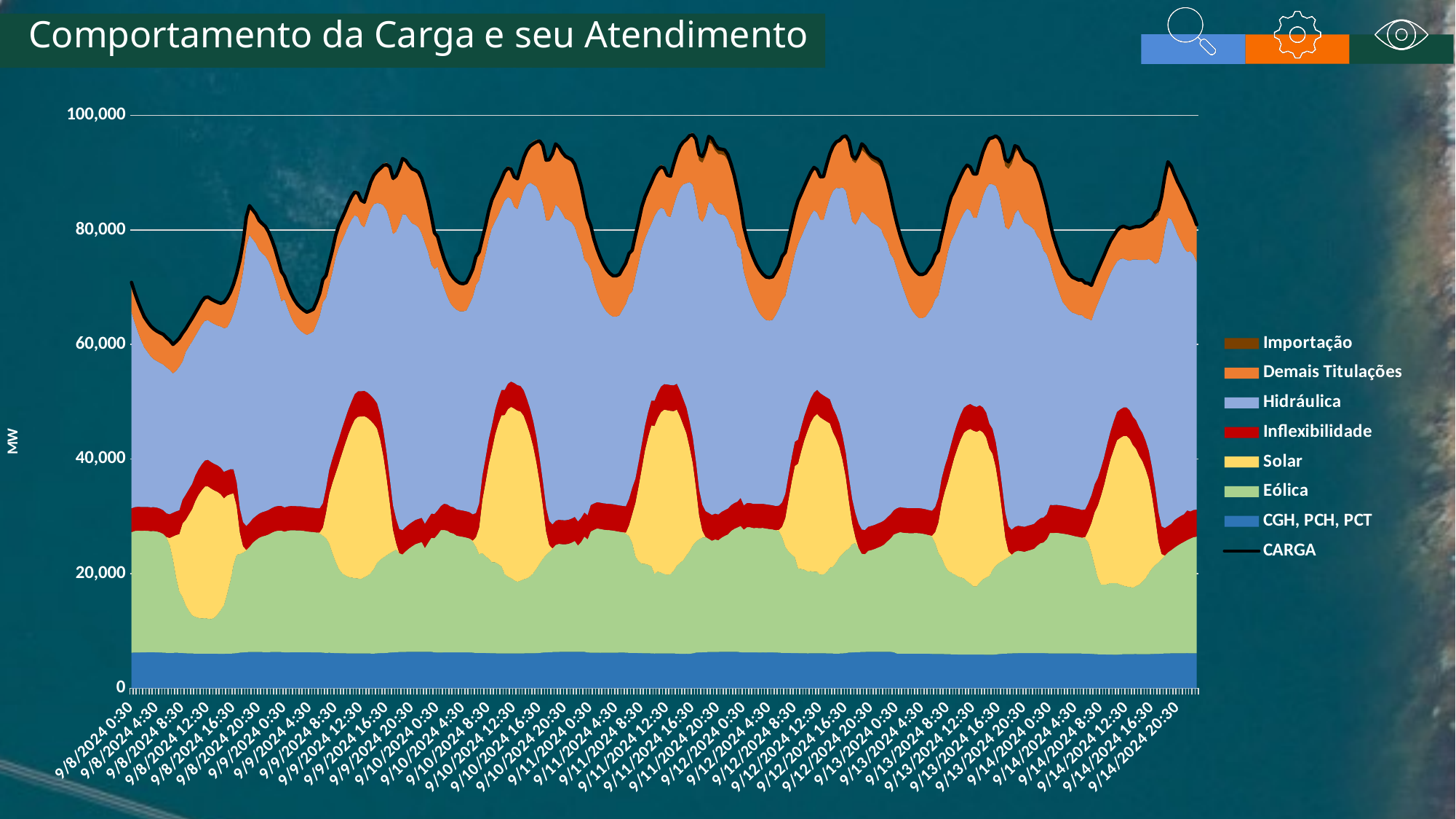
What is the label on the vertical axis? MW Which series is plotted as a black line rather than a filled area? CARGA Is the highest value reached by CARGA greater or less than 100,000? less Is the value of CARGA at 9/8/2024 0:30 greater or less than 80,000? less Which series occupies the bottom layer of the stacked areas? CGH, PCH, PCT What kind of chart is shown on the slide? Stacked area chart with a line Which series occupies the largest area of the stack? Hidráulica Is the peak value of CARGA on 9/11/2024 greater or less than 80,000? greater How many different days are covered on the x axis? 7 Does the Solar series rise or fall from 9/10/2024 12:30 to 9/10/2024 20:30? fall How many series does the legend list? 8